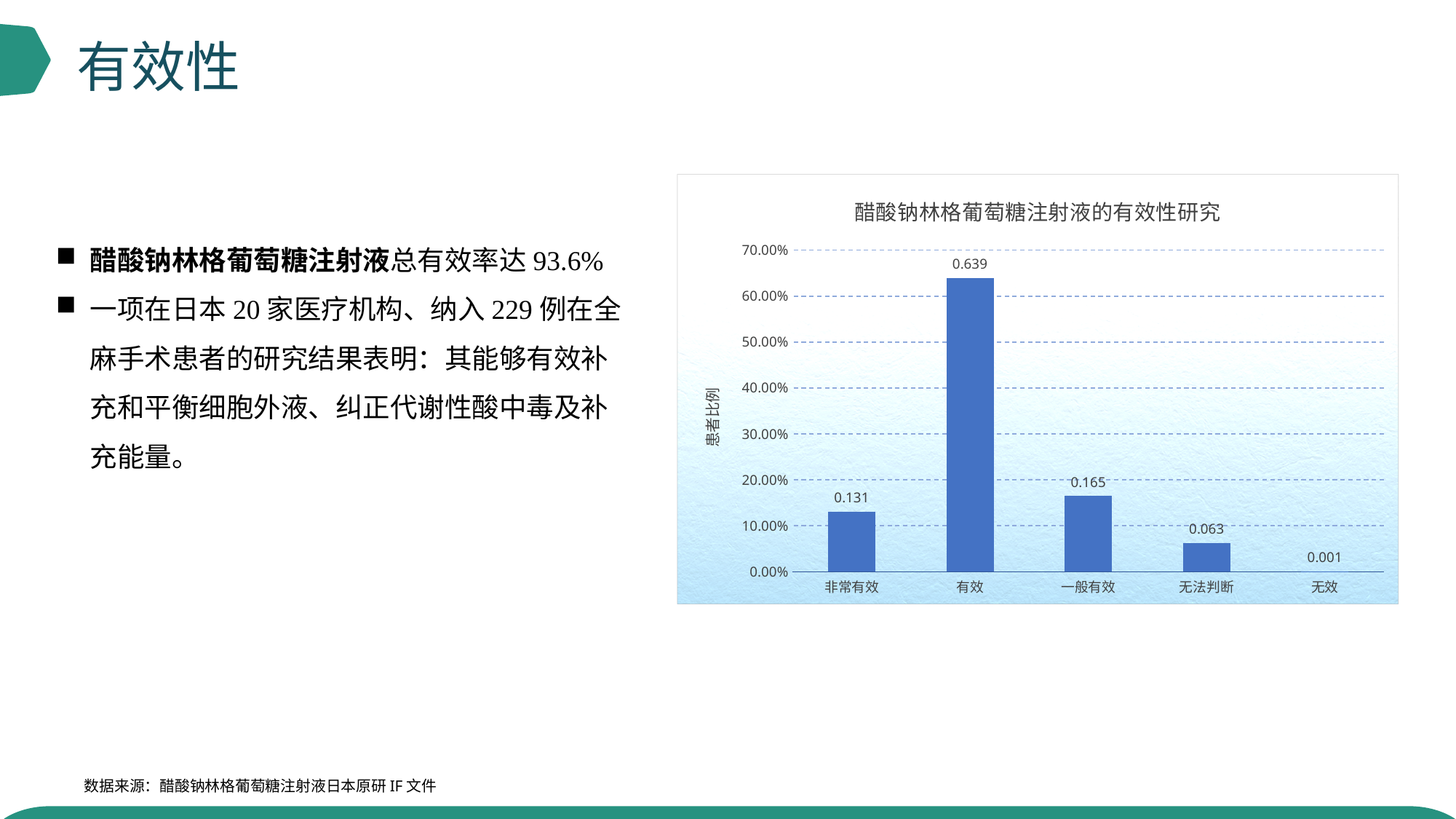
What is the value for 无法判断 in the chart? 0.063 Which is larger, the value for 一般有效 or the value for 非常有效? 一般有效 What is the value for 非常有效 in the chart? 0.131 Which category has the highest value? 有效 What kind of chart is shown on the slide? bar chart Which category has the lowest value? 无效 What is the value for 无效 in the chart? 0.001 How many categories are shown on the x axis? 5 What is the value for 有效 in the chart? 0.639 What is the difference between the values for 有效 and 一般有效? 0.474 Is the value for 有效 greater or less than 60.00%? greater What is the title of the chart? 醋酸钠林格葡萄糖注射液的有效性研究